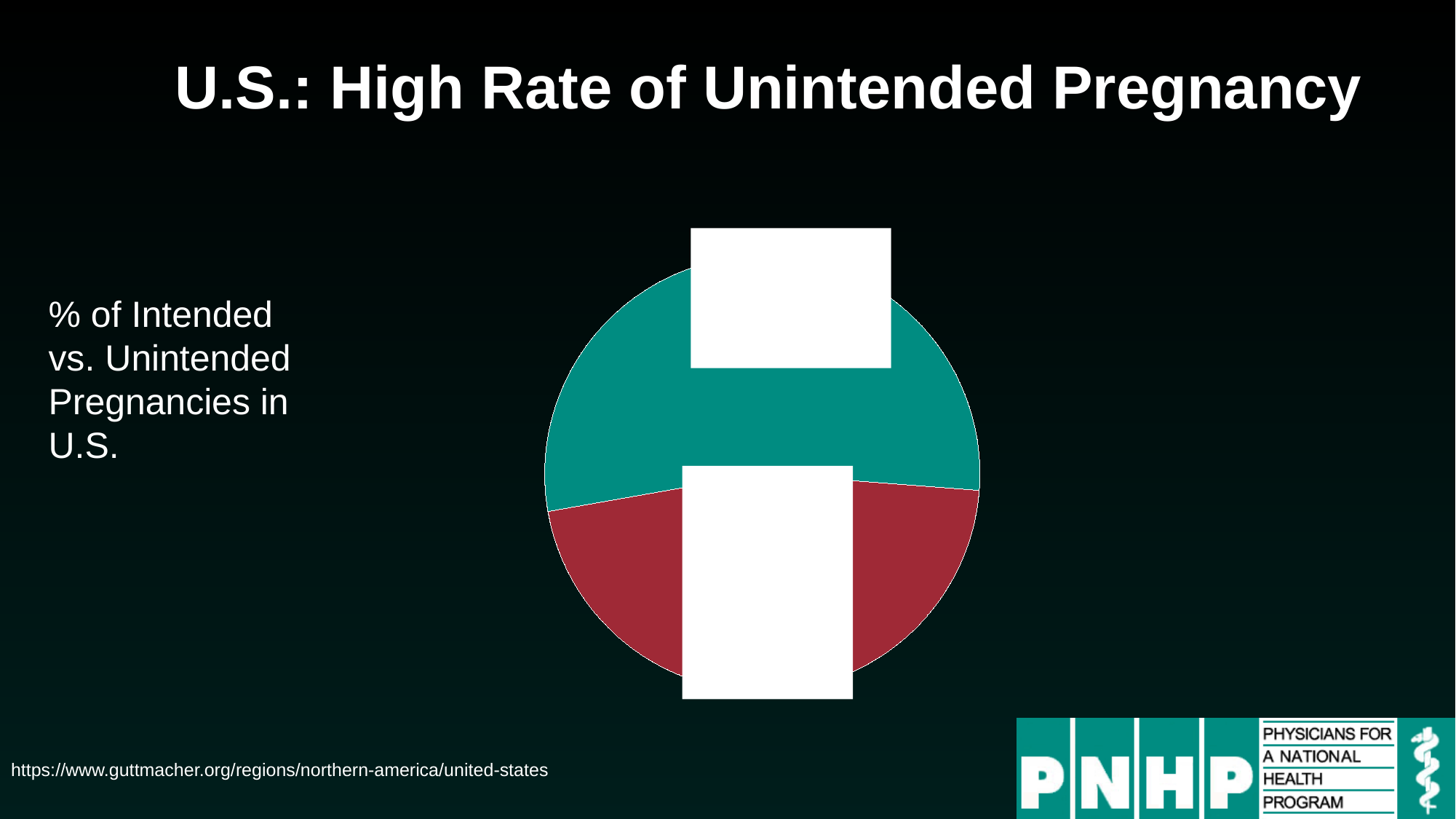
Is the share of the dark red slice greater or less than 50%? less What is the caption describing the pie chart on the left of the slide? % of Intended vs. Unintended Pregnancies in U.S. Which colour slice takes up the largest share of the pie chart? teal Is the share of the teal slice greater or less than 50%? greater What kind of chart is shown on the slide? pie chart What is the title of the slide? U.S.: High Rate of Unintended Pregnancy Which colour slice takes up the smallest share of the pie chart? dark red Which slice of the pie chart is larger, the teal one or the dark red one? teal How many slices does the pie chart have? 2